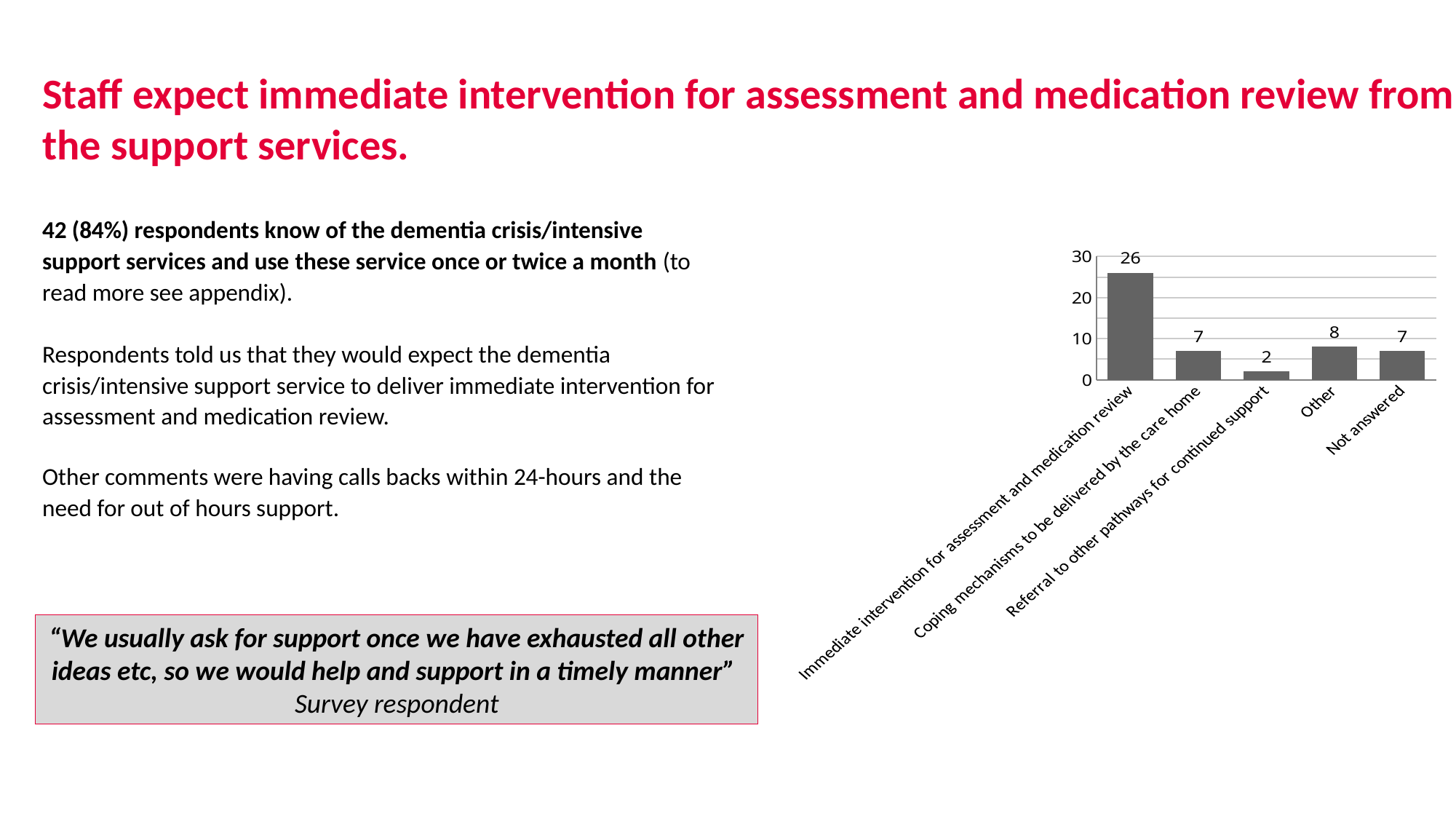
What is the value for 'Referral to other pathways for continued support'? 2 What is the value for 'Coping mechanisms to be delivered by the care home'? 7 What is the difference between the values for 'Immediate intervention for assessment and medication review' and 'Other'? 18 How many categories are shown in the chart? 5 What is the value for 'Immediate intervention for assessment and medication review'? 26 What is the value for 'Not answered'? 7 Which is larger, the value for 'Other' or the value for 'Referral to other pathways for continued support'? Other Which category has the lowest value? Referral to other pathways for continued support Which category has the highest value? Immediate intervention for assessment and medication review Is the value for 'Immediate intervention for assessment and medication review' greater or less than 20? greater What is the value for 'Other'? 8 What kind of chart is shown on the slide? Bar chart